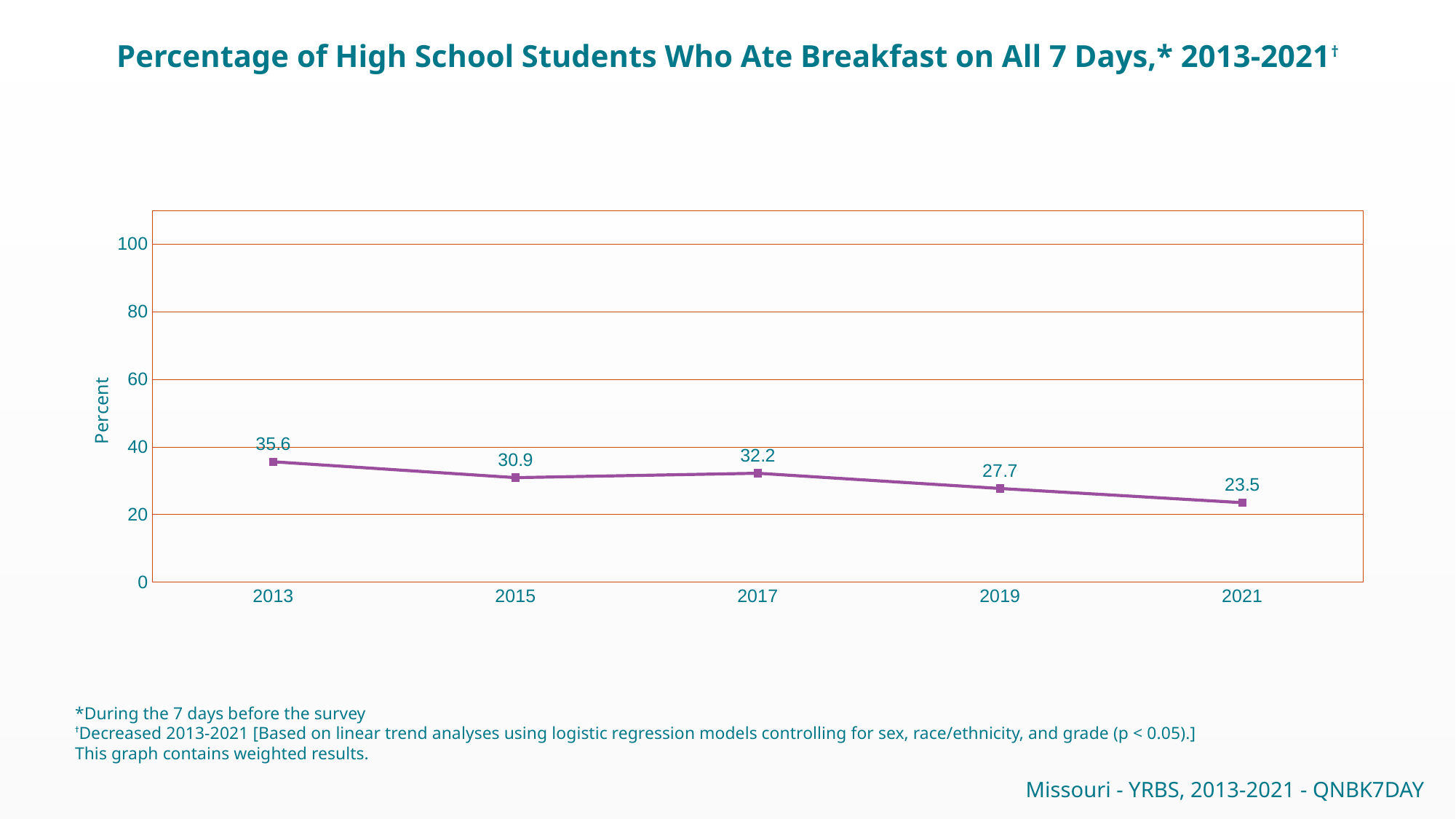
What is the difference between the 2013 value and the 2021 value? 12.1 How many years are plotted on the chart? 5 Which year has the lowest percentage of students who ate breakfast on all 7 days? 2021 What is the label on the y axis? Percent What is the value plotted for 2021? 23.5 What kind of chart is shown on the slide? line chart Is the value for 2019 greater or less than 40? less Which year has the highest percentage of students who ate breakfast on all 7 days? 2013 Overall, do the values rise or fall from 2013 to 2021? fall What is the value plotted for 2017? 32.2 What percentage of high school students ate breakfast on all 7 days in 2013? 35.6 Which year has a larger value, 2015 or 2017? 2017